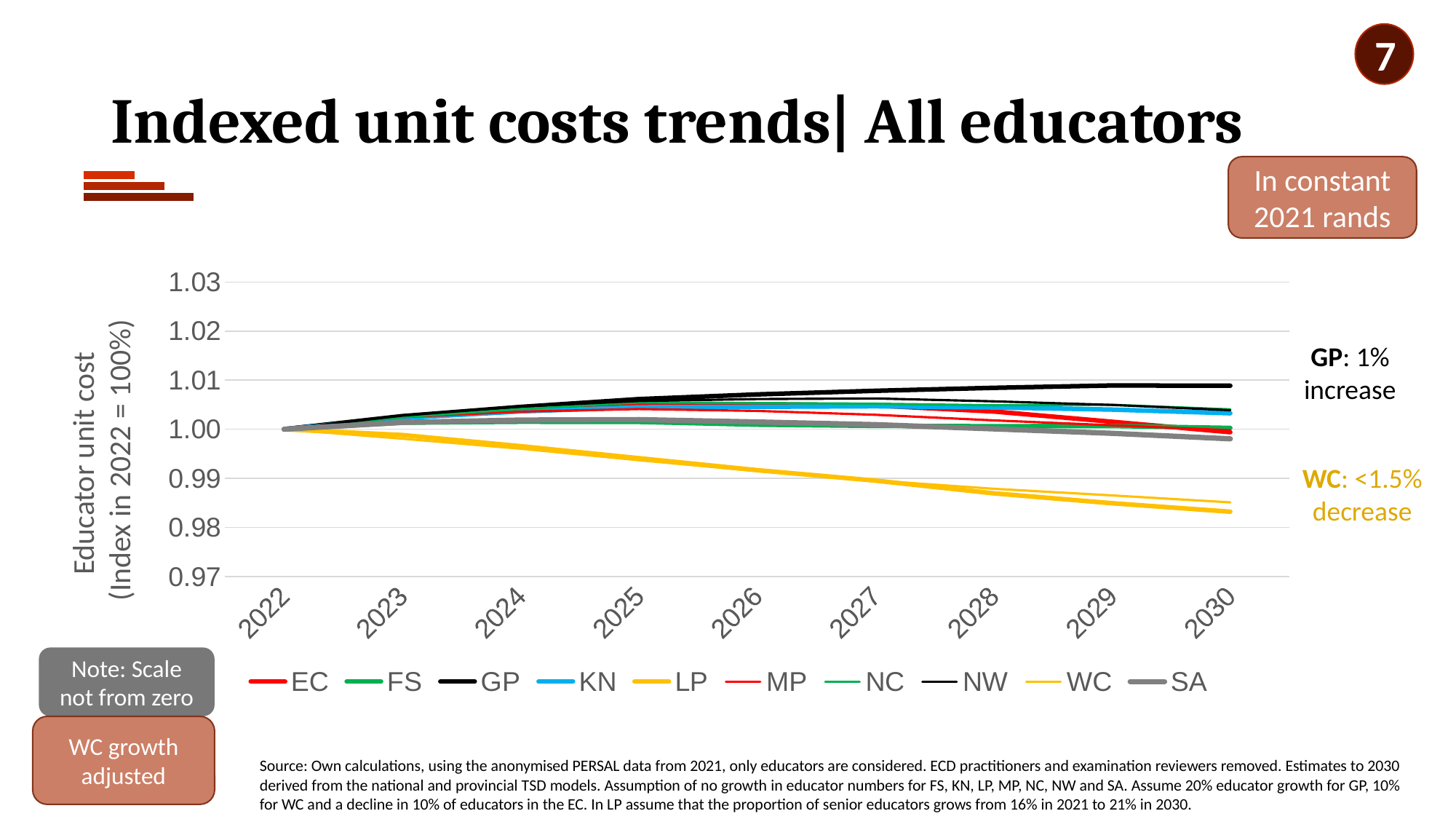
What is the title of the chart on the slide? Indexed unit costs trends| All educators What is the indexed value of every series in 2022? 1.00 In 2030, which is larger: the value for GP or the value for LP? GP Is the value for GP in 2030 greater or less than 1.00? greater Is the value for LP in 2030 greater or less than 0.99? less According to the annotation on the chart, what change does GP show? 1% increase How many years are shown along the x axis? 9 Does the LP series rise or fall from 2022 to 2030? fall Does the GP series rise or fall from 2022 to 2030? rise What kind of chart is shown on the slide? line chart How many series does the legend list? 10 Which series has the highest value in 2030? GP